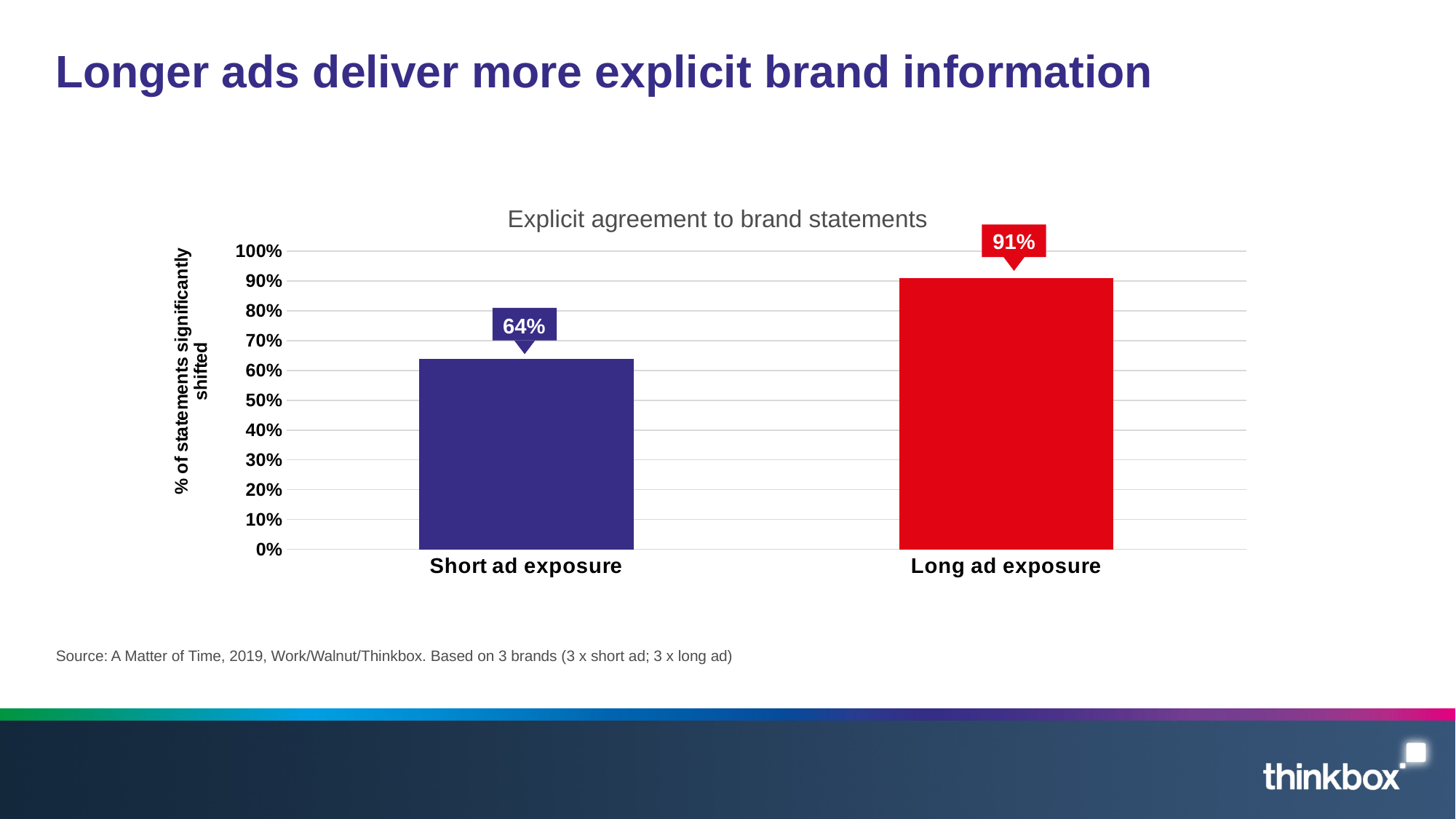
What is the difference between the values for Long ad exposure and Short ad exposure? 27% What kind of chart is shown on the slide? Bar chart Which is larger, the value for Short ad exposure or Long ad exposure? Long ad exposure Is the value for Long ad exposure greater or less than 90%? greater How many categories are shown on the x axis? 2 What colour is the bar for Long ad exposure? Red What is the value for Short ad exposure? 64% Which category has the highest value? Long ad exposure What is the title of the chart? Explicit agreement to brand statements What is the value for Long ad exposure? 91% Is the value for Short ad exposure greater or less than 70%? less Which category has the lowest value? Short ad exposure